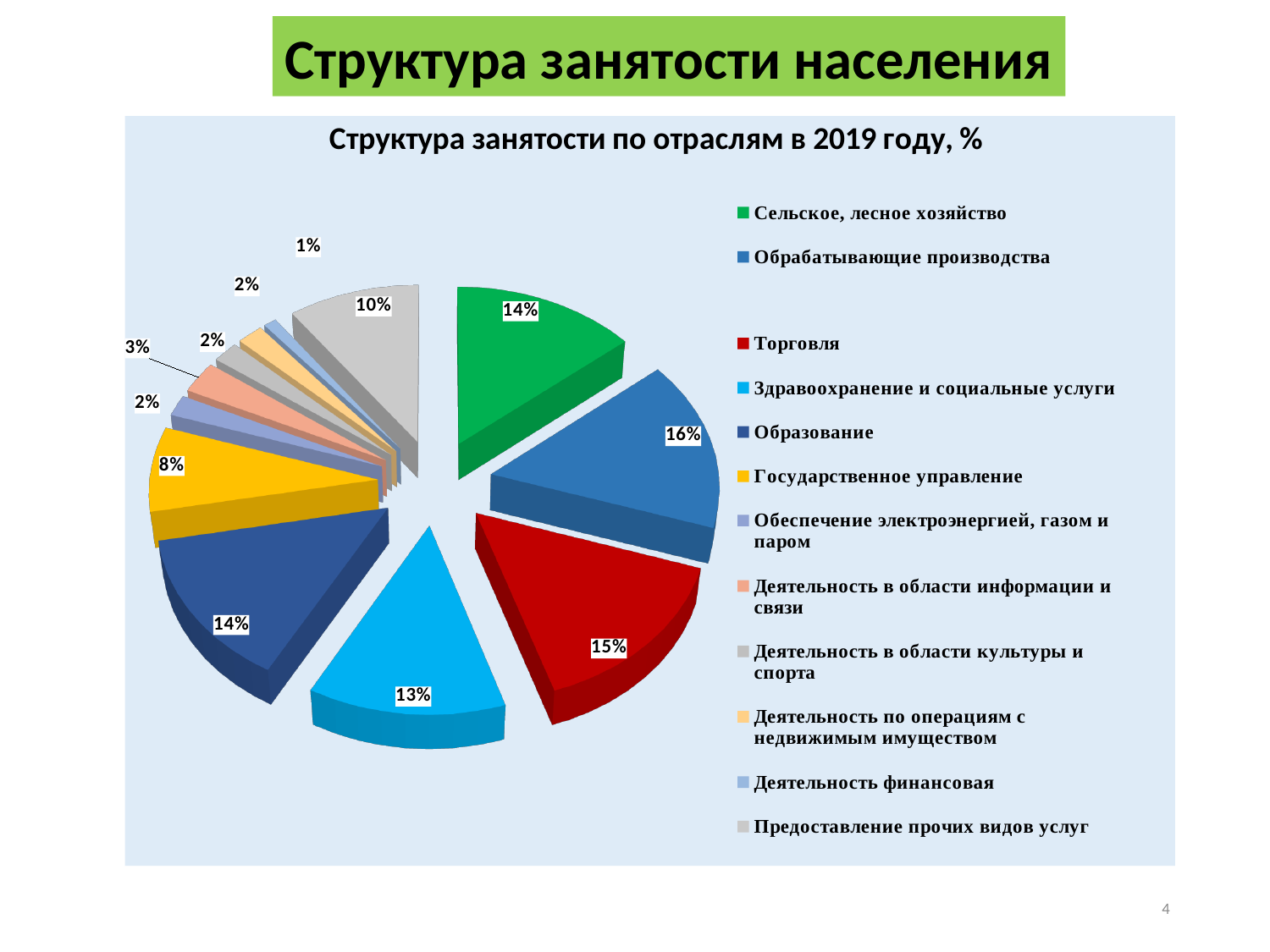
Which sector has the largest share in the pie chart? Обрабатывающие производства Which sector has the smallest share in the pie chart? Деятельность финансовая Which is larger, the share for Торговля or the share for Здравоохранение и социальные услуги? Торговля What kind of chart is shown on the slide? pie chart What is the value for Торговля in the pie chart? 15% What is the value for Государственное управление? 8% How many sectors are listed in the legend of the pie chart? 12 What share of employment does Обрабатывающие производства have in the pie chart? 16% What share does Предоставление прочих видов услуг have? 10% What is the value for Здравоохранение и социальные услуги? 13% What is the title of the chart? Структура занятости по отраслям в 2019 году, % What is the difference in percentage points between Обрабатывающие производства and Здравоохранение и социальные услуги? 3